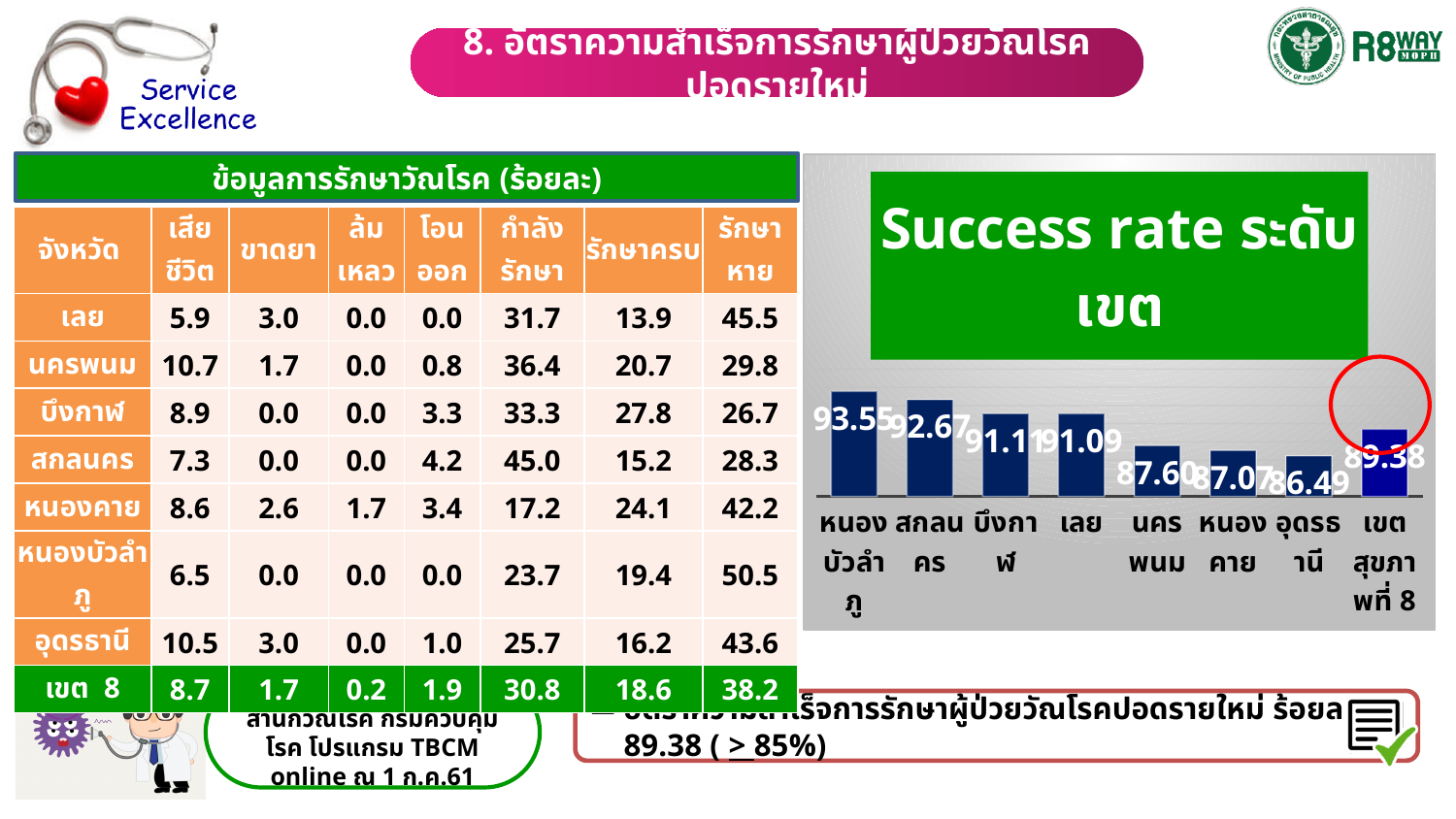
In the Success rate ระดับเขต chart, which category has the lowest value? อุดรธานี What is the title of the chart on the right side of the slide? Success rate ระดับเขต In the Success rate ระดับเขต chart, what is the difference between the values for หนองบัวลำภู and อุดรธานี? 7.06 In the Success rate ระดับเขต chart, what is the difference between the values for สกลนคร and หนองคาย? 5.60 What type of chart is shown on the right side of the slide? bar chart How many bars are plotted in the Success rate ระดับเขต chart? 8 In the Success rate ระดับเขต chart, which is larger, the value for นครพนม or the value for สกลนคร? สกลนคร In the Success rate ระดับเขต chart, what is the value for เขตสุขภาพที่ 8? 89.38 In the Success rate ระดับเขต chart, which province has the highest success rate? หนองบัวลำภู In the Success rate ระดับเขต chart, what is the value for หนองบัวลำภู? 93.55 In the Success rate ระดับเขต chart, what is the value for อุดรธานี? 86.49 In the Success rate ระดับเขต chart, what is the value for สกลนคร? 92.67